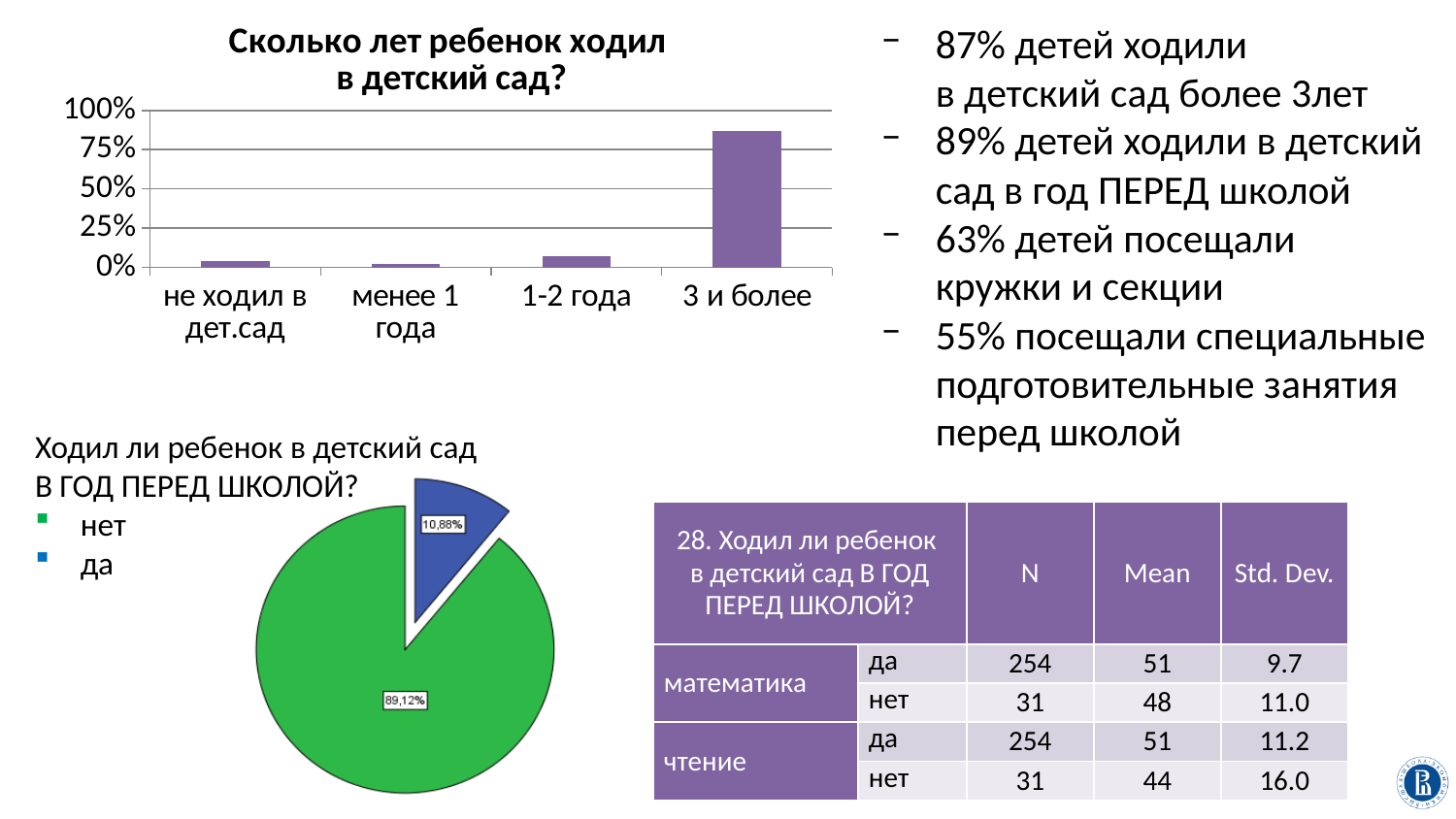
In the bar chart "Сколько лет ребенок ходил в детский сад?", is the value for "не ходил в дет.сад" greater or less than 25%? less In the bar chart "Сколько лет ребенок ходил в детский сад?", is the value for "1-2 года" greater or less than 25%? less In the bar chart "Сколько лет ребенок ходил в детский сад?", which is larger: the bar for "3 и более" or the bar for "1-2 года"? 3 и более What kind of chart is the chart next to "Ходил ли ребенок в детский сад В ГОД ПЕРЕД ШКОЛОЙ?"? pie chart What is the highest tick label on the y axis of the bar chart "Сколько лет ребенок ходил в детский сад?"? 100% How many categories are shown on the x axis of the bar chart "Сколько лет ребенок ходил в детский сад?"? 4 In the pie chart next to "Ходил ли ребенок в детский сад В ГОД ПЕРЕД ШКОЛОЙ?", what share is shown on the green slice? 89,12% In the bar chart "Сколько лет ребенок ходил в детский сад?", which category has the highest bar? 3 и более How many entries does the legend of the pie chart "Ходил ли ребенок в детский сад В ГОД ПЕРЕД ШКОЛОЙ?" list? 2 What kind of chart is the chart titled "Сколько лет ребенок ходил в детский сад?"? bar chart In the bar chart "Сколько лет ребенок ходил в детский сад?", is the value for "3 и более" greater or less than 75%? greater In the pie chart next to "Ходил ли ребенок в детский сад В ГОД ПЕРЕД ШКОЛОЙ?", what share is shown on the blue slice? 10,88%